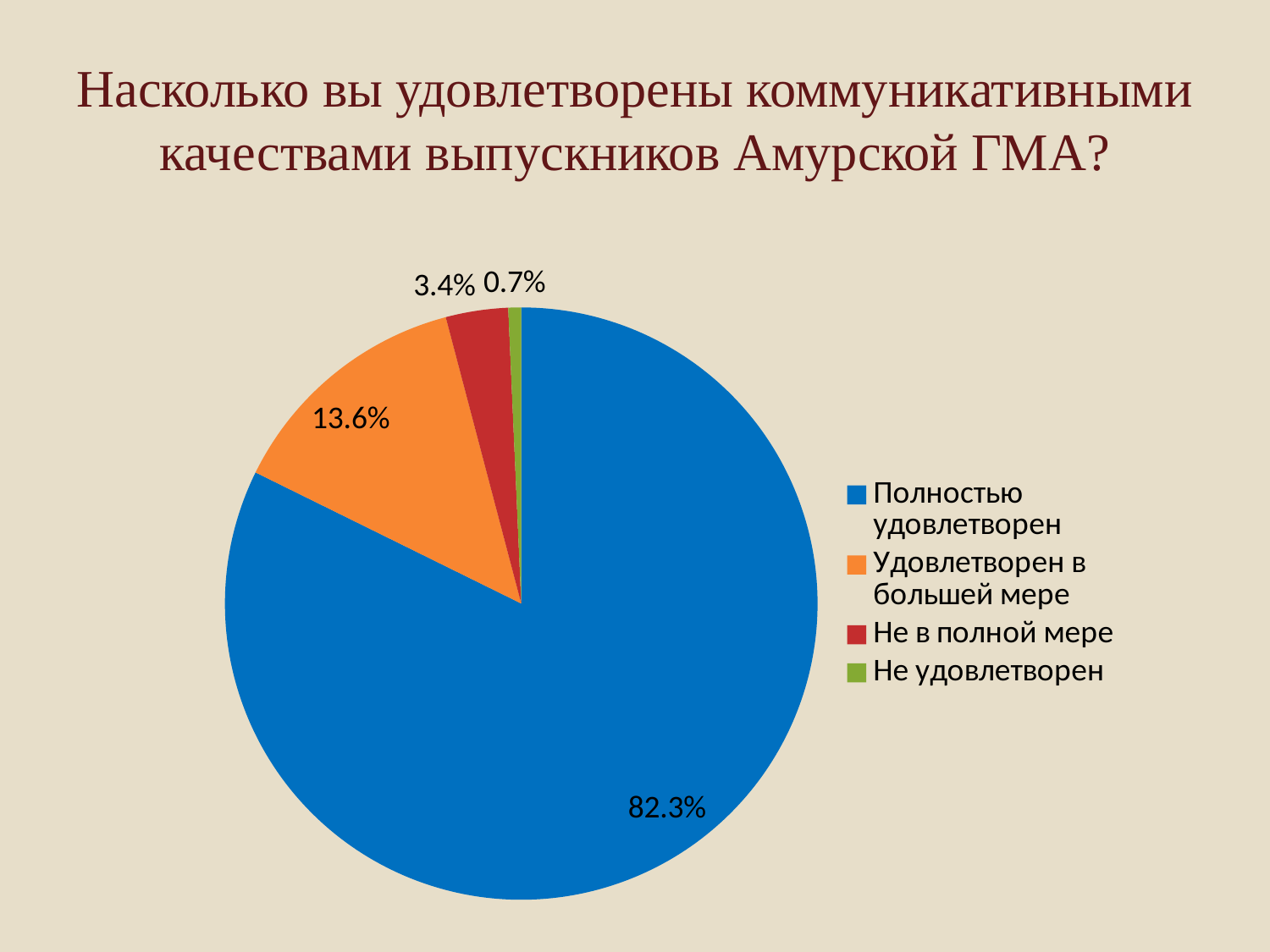
What kind of chart is shown on the slide? pie chart What share of respondents answered "Полностью удовлетворен"? 82.3% What share of respondents answered "Удовлетворен в большей мере"? 13.6% What share of respondents answered "Не удовлетворен"? 0.7% Which category has the smallest slice of the pie? Не удовлетворен Which is larger: the share for "Удовлетворен в большей мере" or the share for "Не в полной мере"? Удовлетворен в большей мере What share of respondents answered "Не в полной мере"? 3.4% How many categories does the legend list? 4 What is the difference between the shares for "Полностью удовлетворен" and "Удовлетворен в большей мере"? 68.7% What is the difference between the shares for "Не в полной мере" and "Не удовлетворен"? 2.7% Which category has the largest slice of the pie? Полностью удовлетворен What colour is the slice for "Не в полной мере"? red